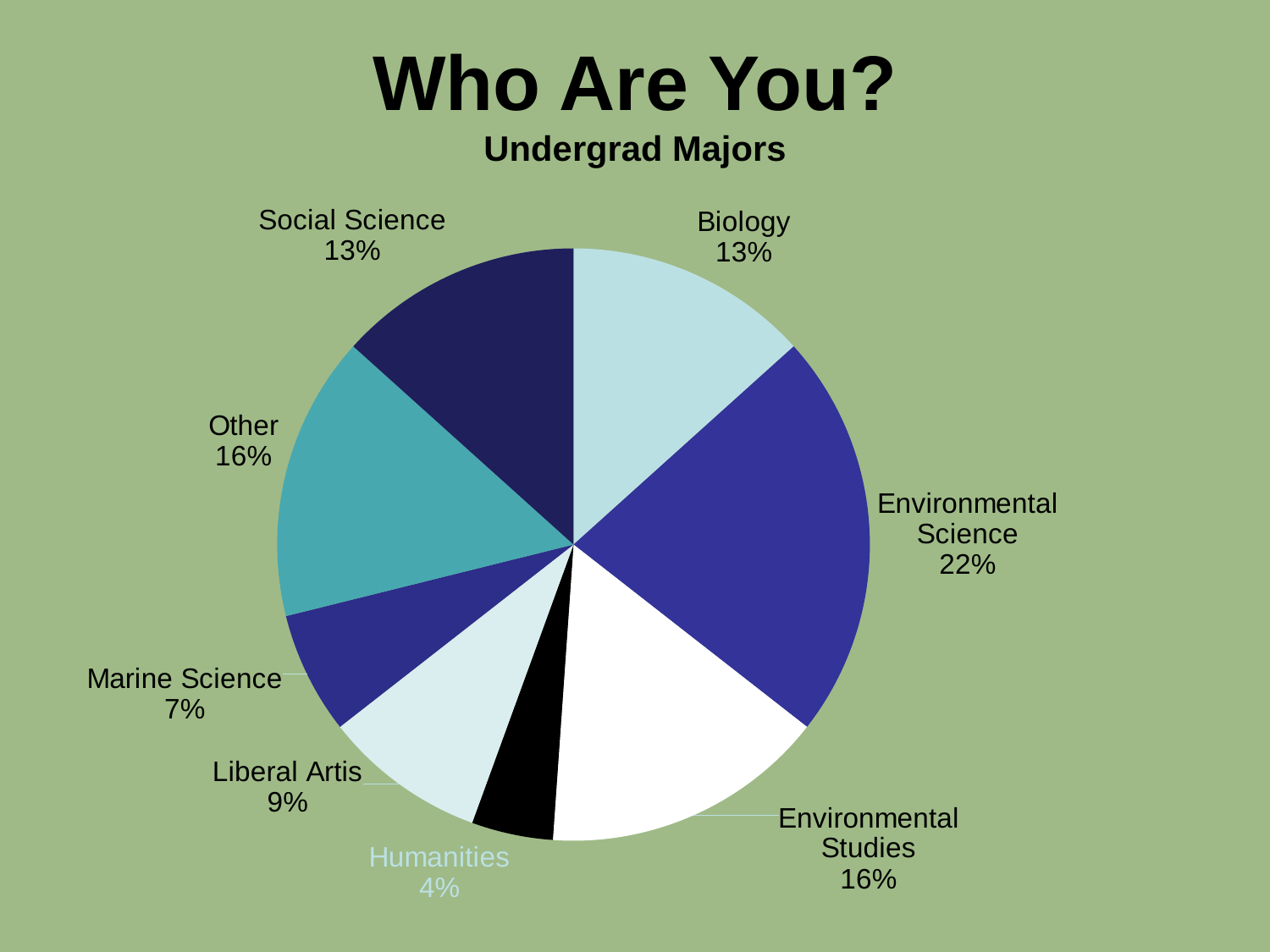
What is the combined share of Social Science and Biology? 26% What is the value shown for Humanities? 4% What is the value shown for Environmental Studies? 16% How many slices does the pie chart have? 8 What is the difference between the Environmental Science share and the Biology share? 9% What kind of chart is shown on the slide? Pie chart Which undergrad major has the largest slice of the pie? Environmental Science What share of the pie does Environmental Science represent? 22% What is the subtitle of the chart below the main title? Undergrad Majors Which undergrad major has the smallest slice of the pie? Humanities Which is larger, the share for Other or the share for Liberal Artis? Other What is the value shown for Marine Science? 7%